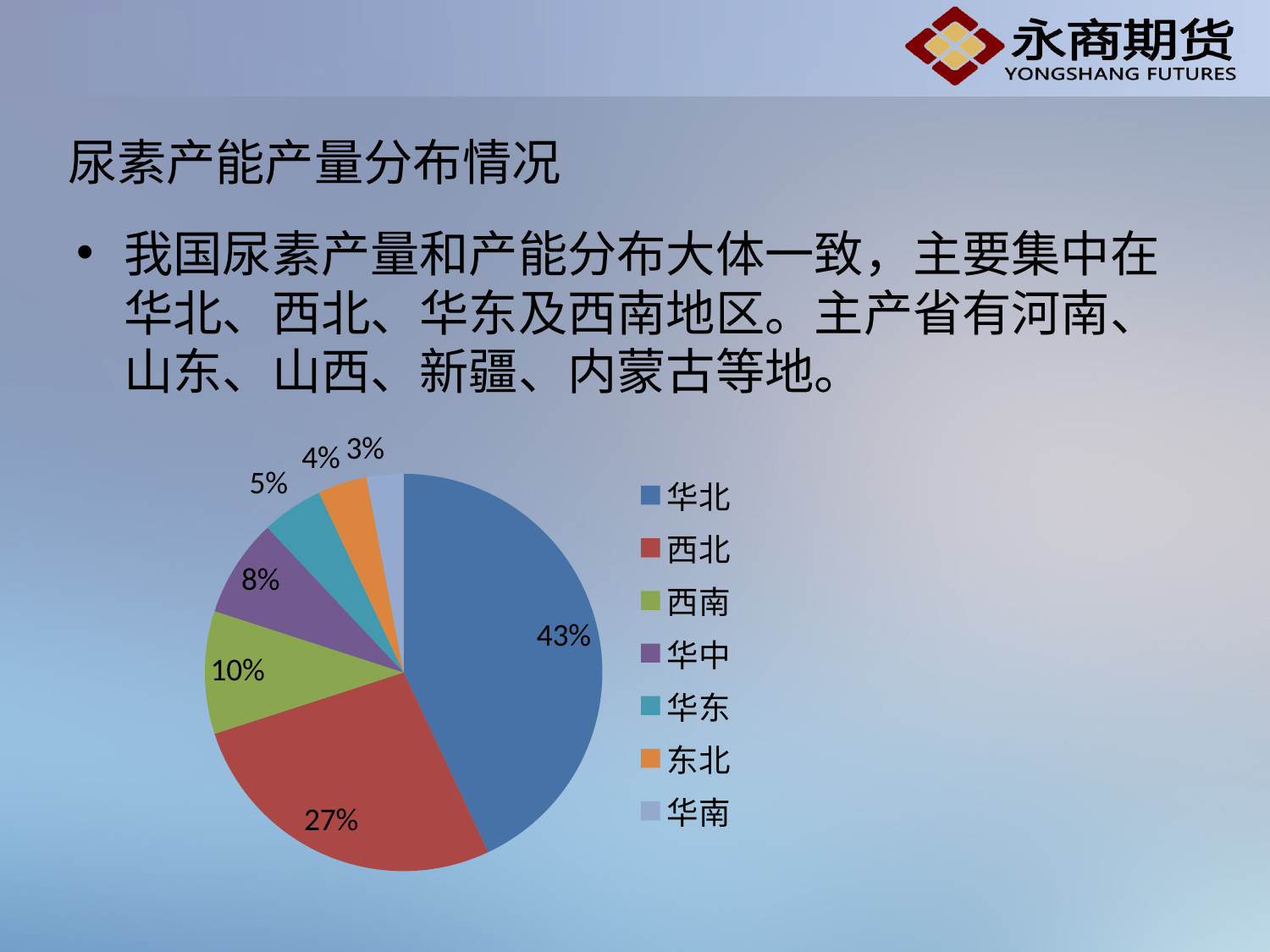
What colour is the slice for 西北? red Which region has the largest slice of the pie? 华北 Which has a larger share, 华东 or 东北? 华东 How many regions are shown in the pie chart? 7 What share of the pie does 西北 have? 27% What share of the pie does 西南 have? 10% What share of the pie does 华北 have? 43% Which region has the smallest slice of the pie? 华南 What kind of chart is shown on the slide? pie chart What is the difference between the shares of 华北 and 西北? 16%